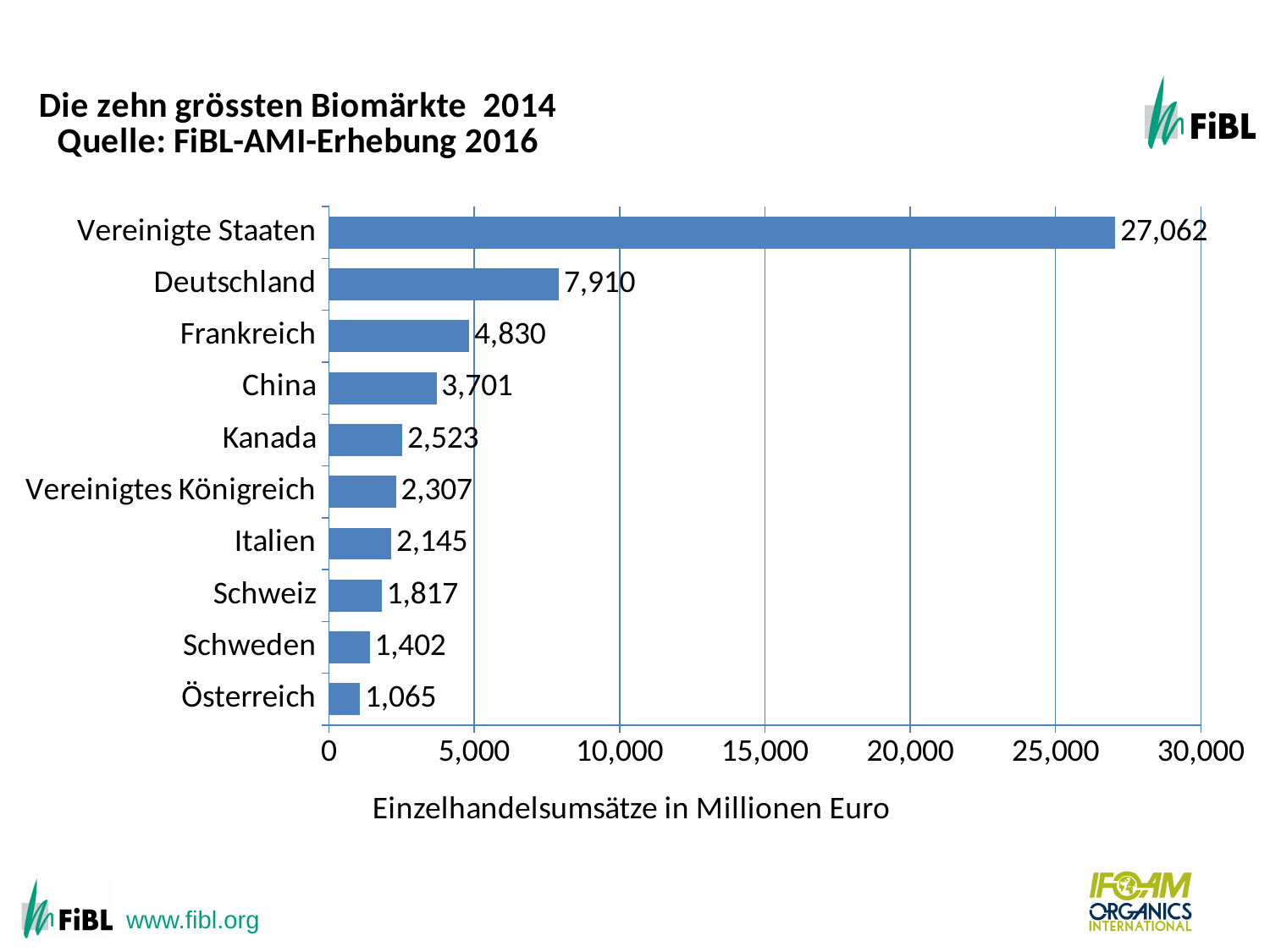
What is the difference between the values for Vereinigte Staaten and Deutschland? 19,152 Which country has the highest value? Vereinigte Staaten Which is larger, the value for Schweiz or the value for Schweden? Schweiz What is the value for Österreich? 1,065 What is the x-axis label of the chart? Einzelhandelsumsätze in Millionen Euro Which country has the lowest value? Österreich How many countries are shown in the chart? 10 What is the value for Deutschland? 7,910 What is the value for Kanada? 2,523 What kind of chart is shown on the slide? bar chart What is the difference between the values for Frankreich and China? 1,129 Is the value for Deutschland greater or less than 5,000? greater